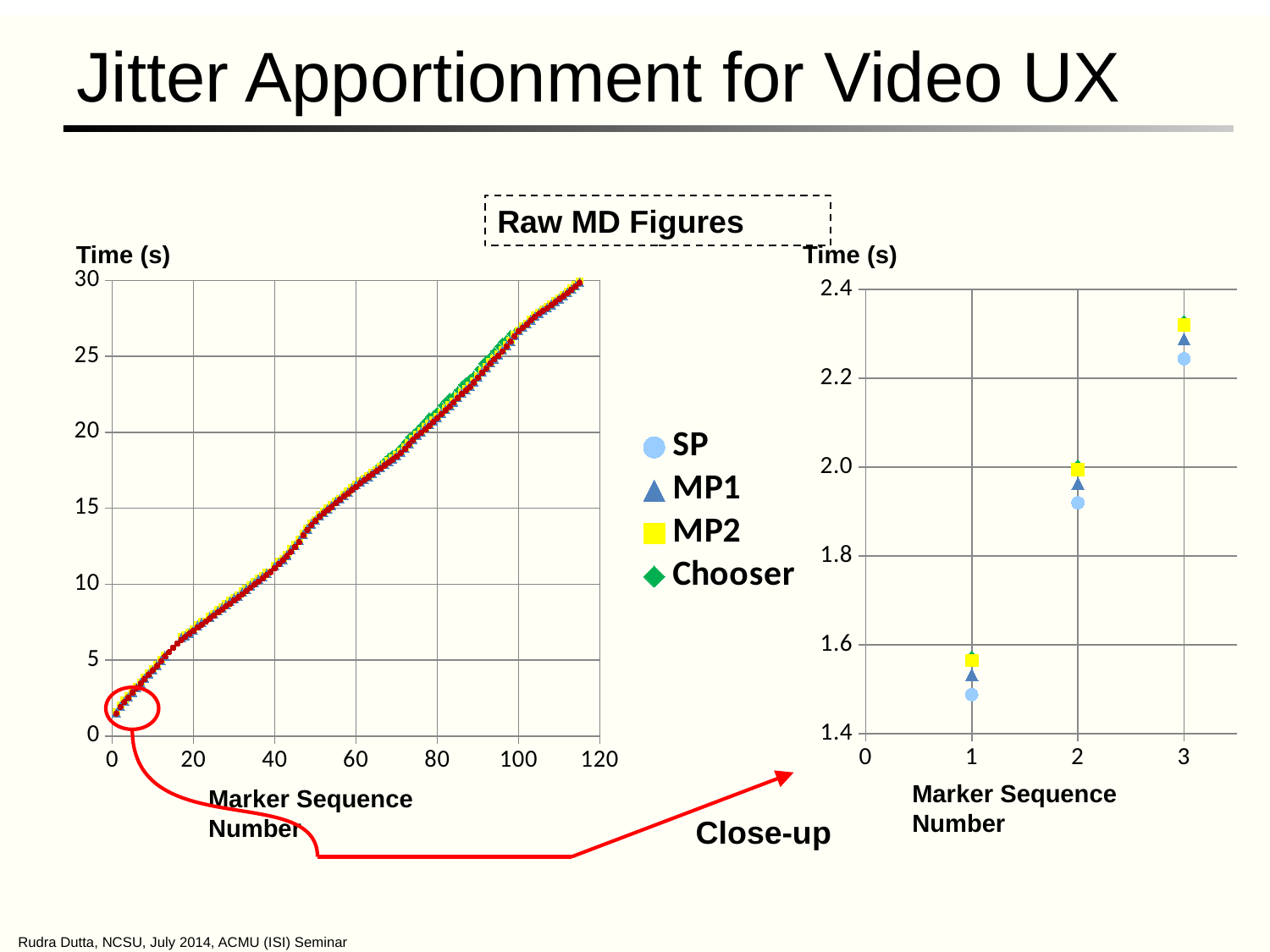
In the Close-up chart on the right, is the value for SP at marker sequence number 1 greater or less than 1.6? less In the Close-up chart on the right, is the value for SP at marker sequence number 2 greater or less than 2.0? less In the Close-up chart on the right, at marker sequence number 3, which is lower: SP or MP2? SP In the Close-up chart on the right, how many marker sequence numbers have plotted points? 3 In the Raw MD Figures chart on the left, is the value at marker sequence number 100 greater or less than 25? greater In the Raw MD Figures chart on the left, do the values rise or fall as the marker sequence number increases? rise How many series does the legend list? 4 Which series are listed in the legend? SP, MP1, MP2, Chooser In the Close-up chart on the right, at marker sequence number 1, which is larger: SP or MP2? MP2 What kind of chart is the Raw MD Figures chart on the left? scatter chart What is the y-axis title of the Raw MD Figures chart on the left? Time (s)